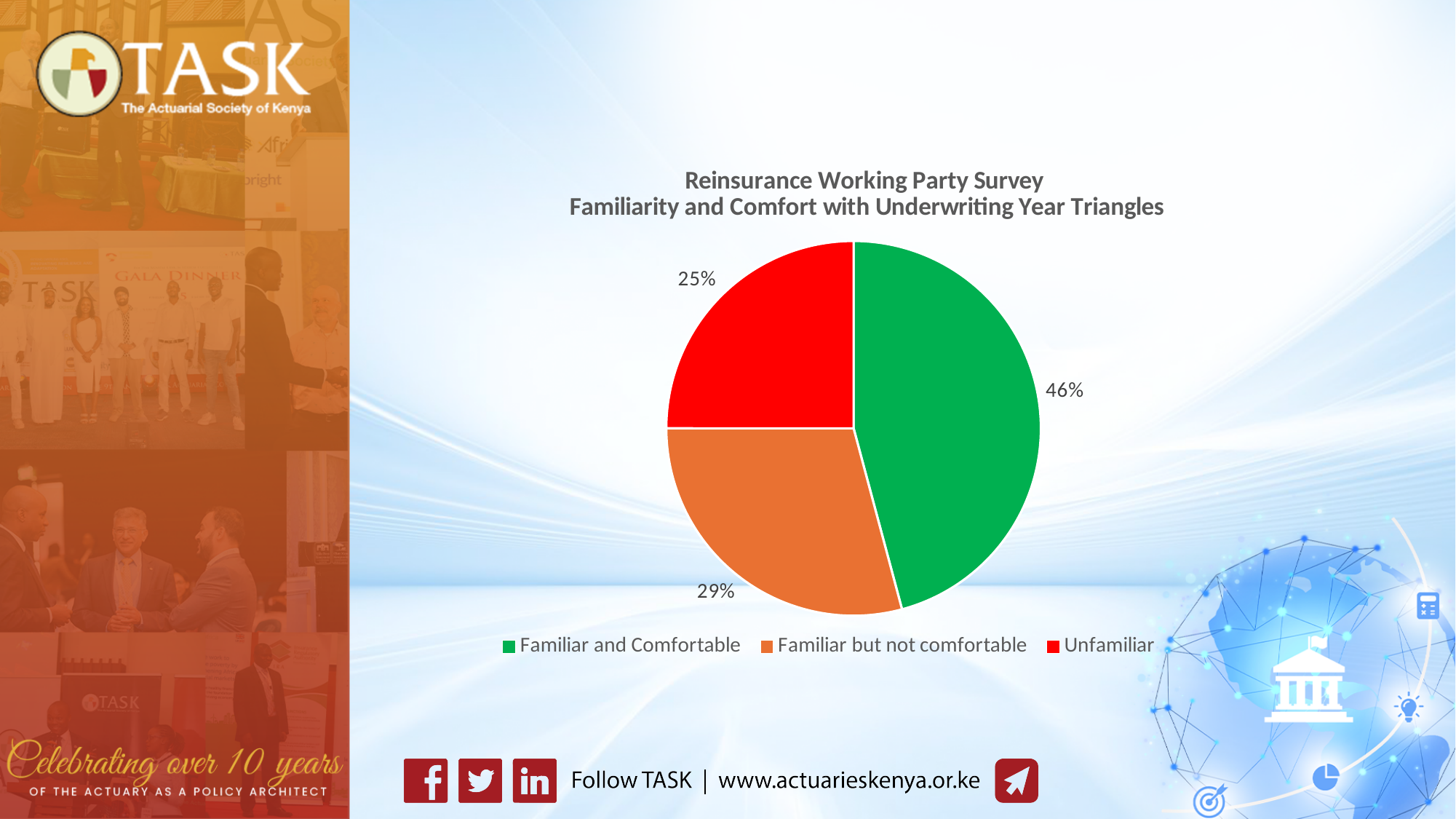
Which category has the smallest share of the pie? Unfamiliar Which category has the largest share of the pie? Familiar and Comfortable Which is larger: the share for Familiar but not comfortable or the share for Unfamiliar? Familiar but not comfortable What is the title of the chart? Reinsurance Working Party Survey Familiarity and Comfort with Underwriting Year Triangles What colour represents the Unfamiliar category? Red What percentage of respondents are Familiar and Comfortable with underwriting year triangles? 46% What percentage of respondents are Unfamiliar? 25% What percentage of respondents are Familiar but not comfortable? 29% How many categories does the pie chart show? 3 What is the difference in percentage points between Familiar and Comfortable and Unfamiliar? 21 What type of chart is shown on the slide? Pie chart What is the difference in percentage points between Familiar but not comfortable and Unfamiliar? 4